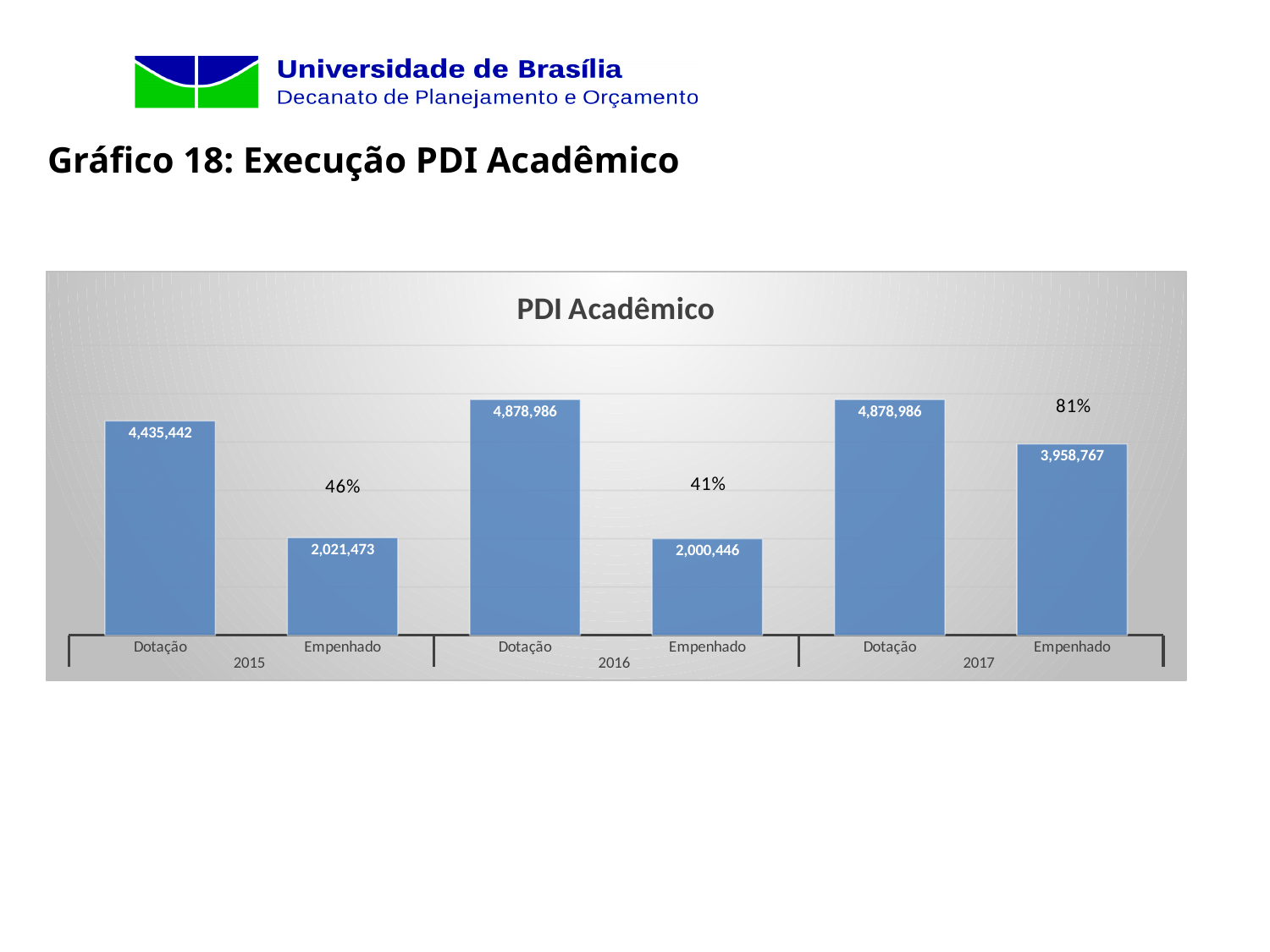
What percentage is shown above the Empenhado bar for 2015? 46% How many bars are plotted in the PDI Acadêmico chart? 6 Which bar has the lowest value in the PDI Acadêmico chart? Empenhado 2016 What is the value of Empenhado for 2016 in the PDI Acadêmico chart? 2,000,446 What is the title of the chart on the slide? PDI Acadêmico What is the value of Empenhado for 2017 in the PDI Acadêmico chart? 3,958,767 What is the difference between Dotação and Empenhado for 2015? 2,413,969 What is the value of Dotação for 2015 in the PDI Acadêmico chart? 4,435,442 What kind of chart is the PDI Acadêmico chart? Bar chart Which is larger, Dotação for 2015 or Dotação for 2016? Dotação for 2016 What is the difference between Dotação and Empenhado for 2017? 920,219 What percentage is shown above the Empenhado bar for 2017? 81%